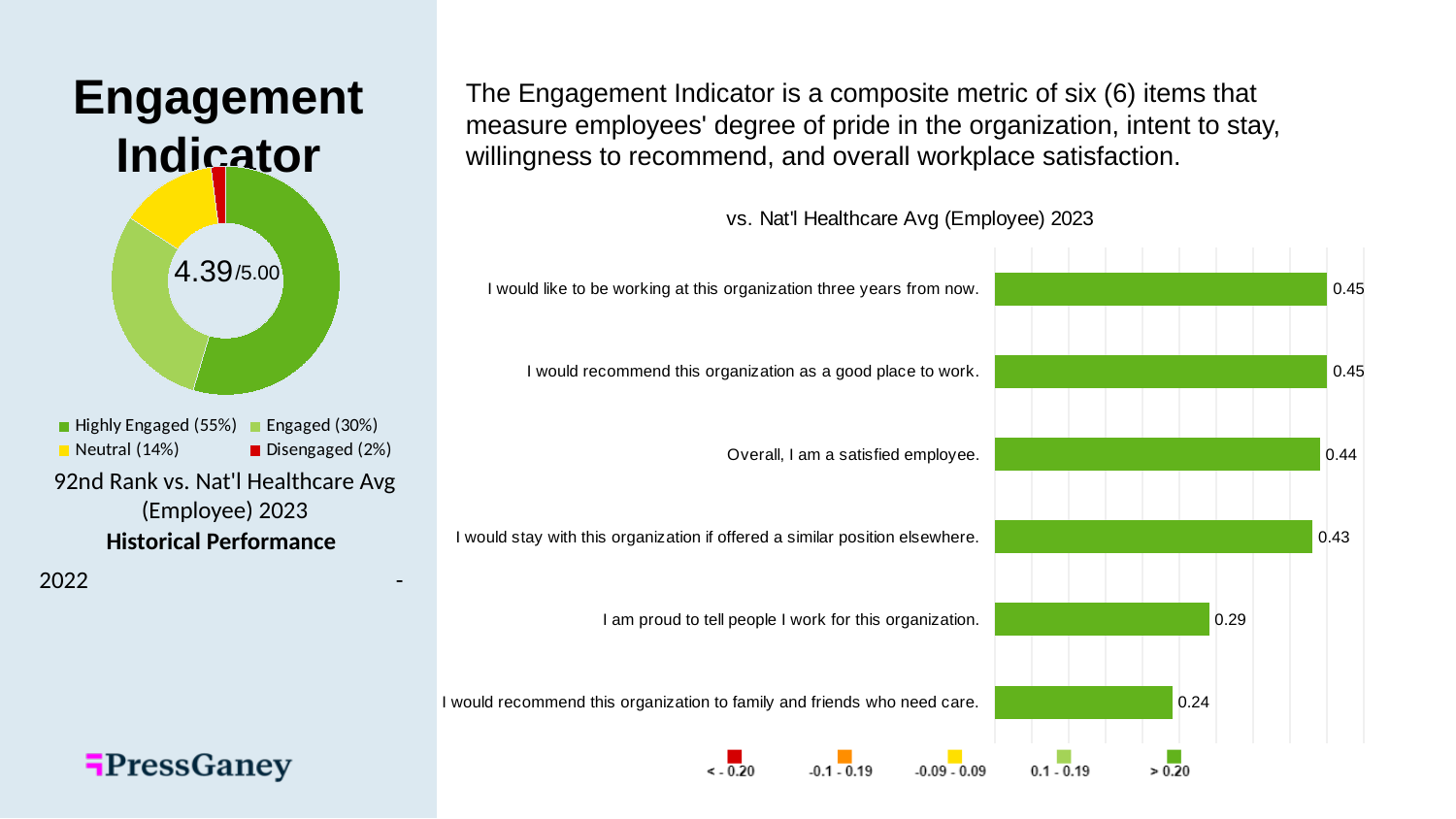
In the bar chart titled "vs. Nat'l Healthcare Avg (Employee) 2023", which is larger: the value for "I am proud to tell people I work for this organization." or the value for "I would recommend this organization to family and friends who need care."? I am proud to tell people I work for this organization. In the bar chart titled "vs. Nat'l Healthcare Avg (Employee) 2023", what is the difference between the values for "I would stay with this organization if offered a similar position elsewhere." and "I would recommend this organization to family and friends who need care."? 0.19 What score is printed in the center of the donut chart on the left of the slide? 4.39/5.00 In the bar chart titled "vs. Nat'l Healthcare Avg (Employee) 2023", which item has the lowest value? I would recommend this organization to family and friends who need care. In the donut chart on the left of the slide, what percentage is shown for Highly Engaged? 55% How many items are plotted in the bar chart titled "vs. Nat'l Healthcare Avg (Employee) 2023"? 6 In the bar chart titled "vs. Nat'l Healthcare Avg (Employee) 2023", what is the value for "Overall, I am a satisfied employee."? 0.44 In the donut chart on the left of the slide, which category has the largest share? Highly Engaged In the donut chart on the left of the slide, what percentage is shown for Disengaged? 2% In the bar chart titled "vs. Nat'l Healthcare Avg (Employee) 2023", what is the value for "I am proud to tell people I work for this organization."? 0.29 What kind of chart is the chart titled "vs. Nat'l Healthcare Avg (Employee) 2023"? Bar chart How many categories does the legend of the donut chart on the left of the slide list? 4